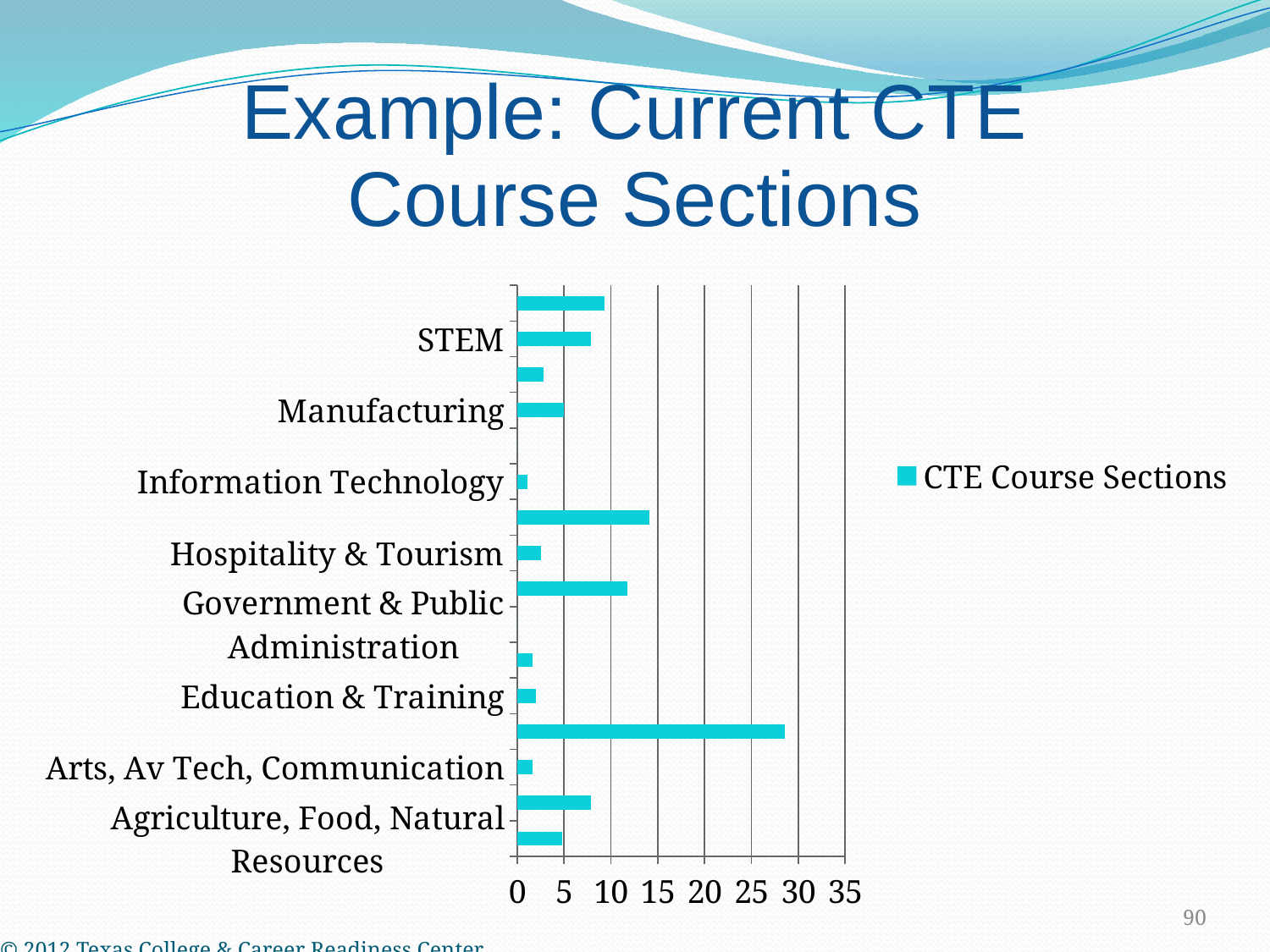
Is the value for STEM greater or less than 10? less What is the title of the slide containing the chart? Example: Current CTE Course Sections How many series does the legend list? 1 Is the longest bar in the chart greater or less than 25? greater What is the name of the series shown in the legend? CTE Course Sections What is the highest value shown on the horizontal axis? 35 Which has the larger value, STEM or Information Technology? STEM Is the value for Information Technology greater or less than 5? less What kind of chart is shown on the slide? Bar chart